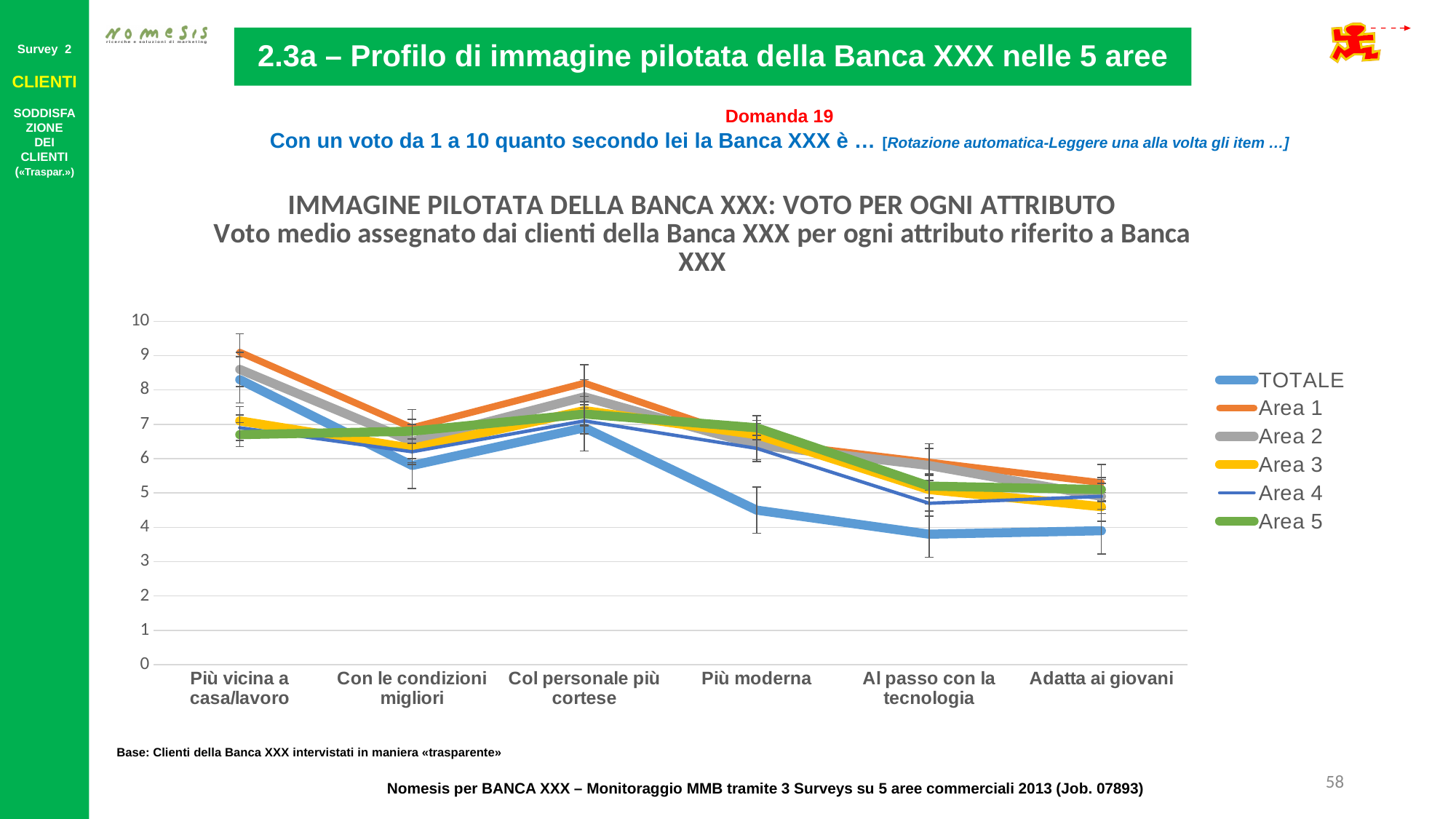
Which series has the highest value for 'Più vicina a casa/lavoro'? Area 1 What kind of chart is shown on the slide? line chart Does the TOTALE line rise or fall from 'Col personale più cortese' to 'Al passo con la tecnologia'? fall Is the Area 1 value for 'Più vicina a casa/lavoro' greater or less than 8? greater What is the maximum value shown on the y axis? 10 For the TOTALE series, which category has the highest value? Più vicina a casa/lavoro Is the TOTALE value for 'Al passo con la tecnologia' greater or less than 5? less Which series has the lowest value for 'Al passo con la tecnologia'? TOTALE How many series does the legend list? 6 For the TOTALE series, which is larger: the value for 'Più vicina a casa/lavoro' or for 'Più moderna'? Più vicina a casa/lavoro How many attribute categories are shown on the x axis? 6 Is the TOTALE value for 'Più moderna' greater or less than 5? less